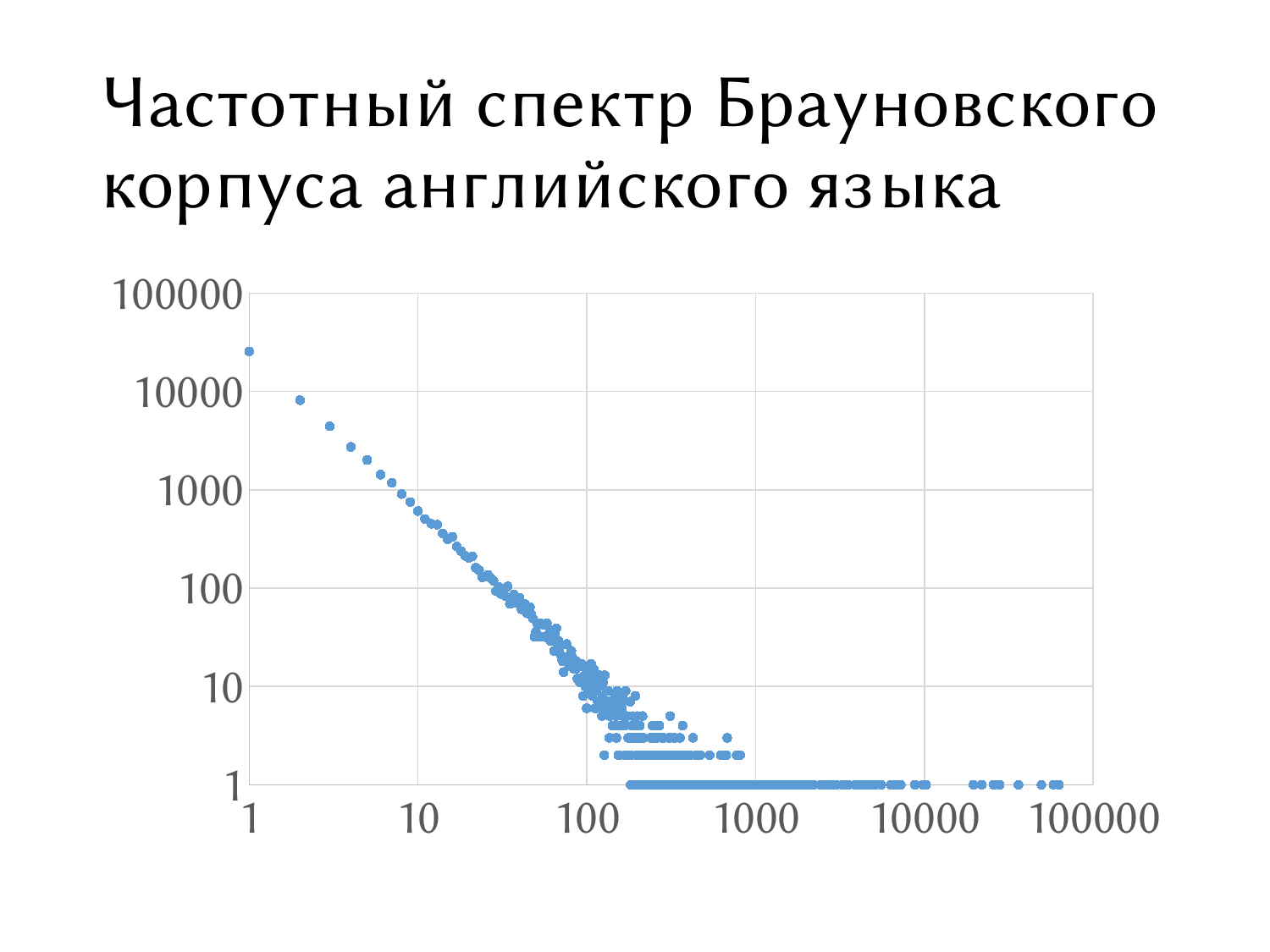
What is the title of the slide containing the chart? Частотный спектр Брауновского корпуса английского языка Is the value of the point at x = 10 greater or less than 100? greater Is the value of the point at x = 10 greater or less than 1000? less Do the plotted values rise or fall as the x-axis value increases? fall What is the largest tick label shown on the x axis? 100000 Is the value of the point at x = 1 greater or less than 100000? less What is the lowest y value that the plotted points reach? 1 What kind of chart is shown on the slide? scatter plot